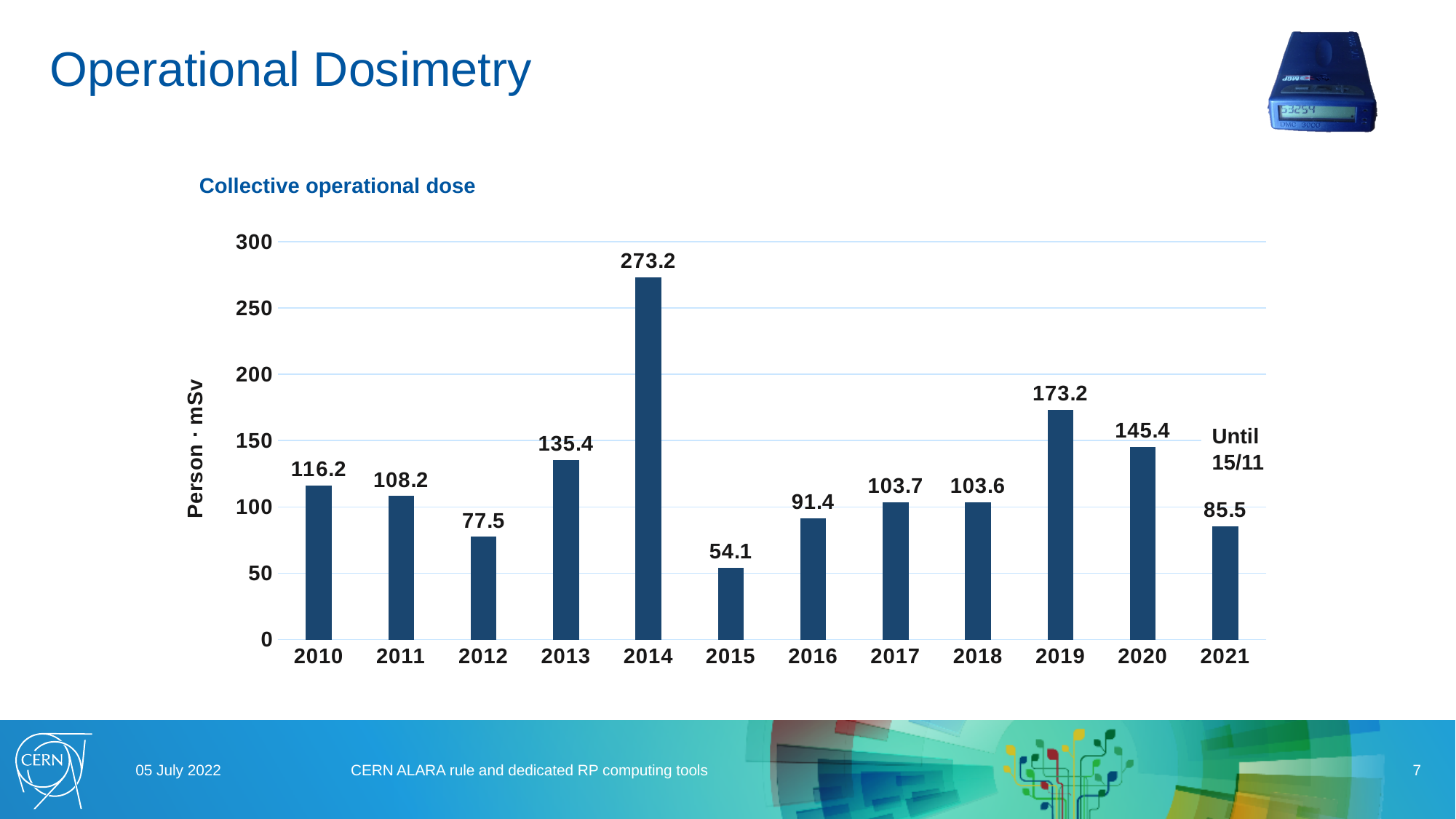
What is the collective operational dose for 2021 (until 15/11)? 85.5 What kind of chart is used to show the collective operational dose? Bar chart Does the collective operational dose rise or fall from 2014 to 2015? Fall What is the difference between the collective operational dose in 2019 and in 2020? 27.8 Which year has the lowest collective operational dose? 2015 Which year has a larger collective operational dose, 2013 or 2016? 2013 What is the unit shown on the y axis of the chart? Person · mSv Which year has the highest collective operational dose? 2014 What is the collective operational dose for 2012? 77.5 Is the collective operational dose for 2019 greater or less than 150? greater How many years are shown on the x axis of the chart? 12 What is the collective operational dose for 2014? 273.2